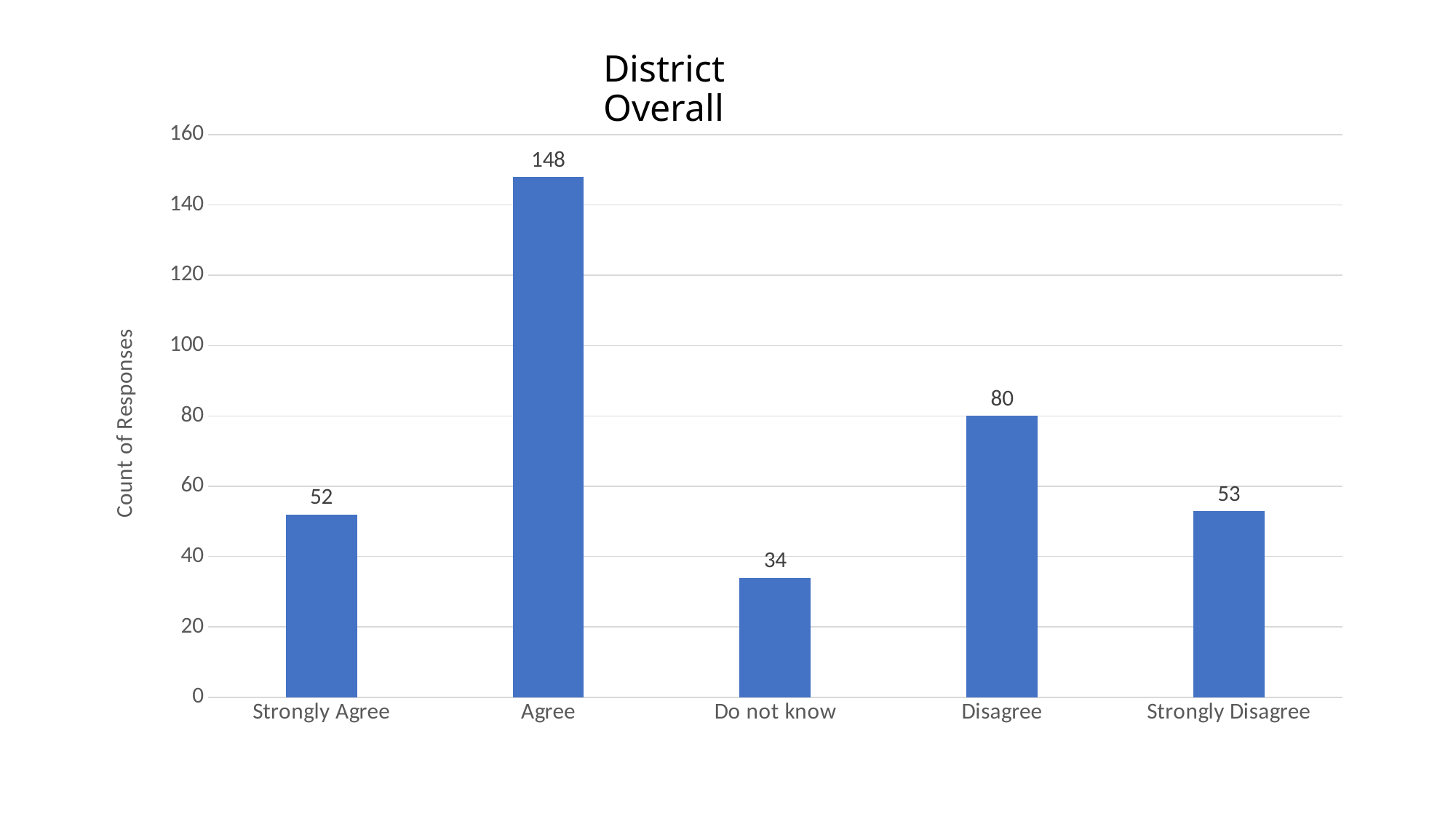
What is the difference between the counts for Agree and Disagree? 68 Which category has the lowest count of responses? Do not know What is the count of responses for Agree? 148 What is the label of the vertical axis? Count of Responses Which has more responses, Disagree or Strongly Agree? Disagree What is the difference between the counts for Strongly Disagree and Strongly Agree? 1 What kind of chart is shown on the slide? Bar chart Which category has the highest count of responses? Agree How many categories are shown on the x axis? 5 What is the count of responses for Disagree? 80 What is the count of responses for Do not know? 34 Is the value for Agree greater or less than 140? greater